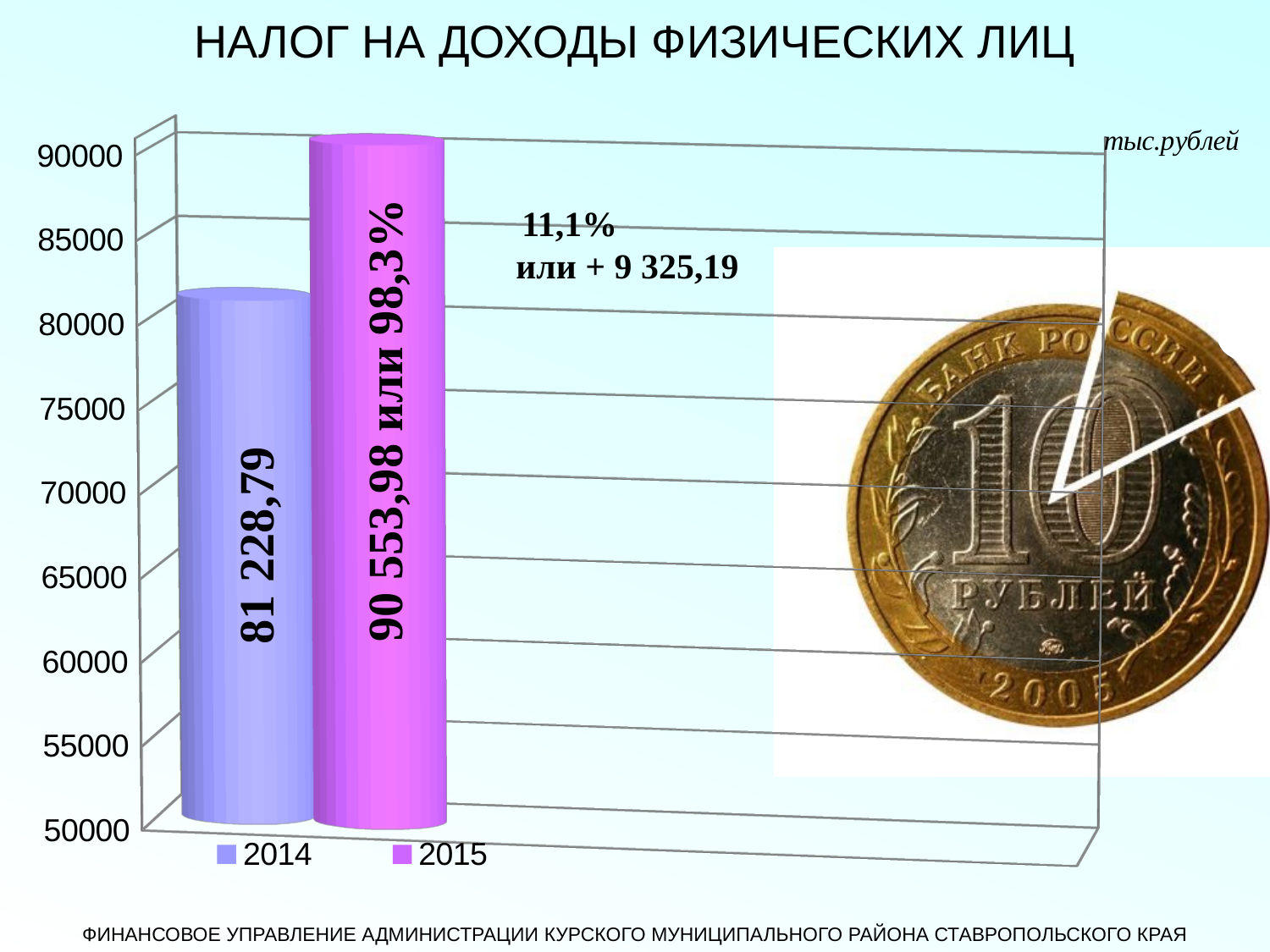
What is the value for 2014? 81 228,79 What kind of chart is shown on the slide? Bar chart Which year has the higher value? 2015 Which year has the lower value? 2014 Is the value for 2014 greater or less than 85000? less How many entries does the legend list? 2 Is the value for 2015 greater or less than 90000? greater What is the difference between the 2015 and 2014 values? 9 325,19 What is the value for 2015? 90 553,98 Is the value for 2015 larger than the value for 2014? Yes What is the title of the chart? НАЛОГ НА ДОХОДЫ ФИЗИЧЕСКИХ ЛИЦ How many bars are plotted on the chart? 2